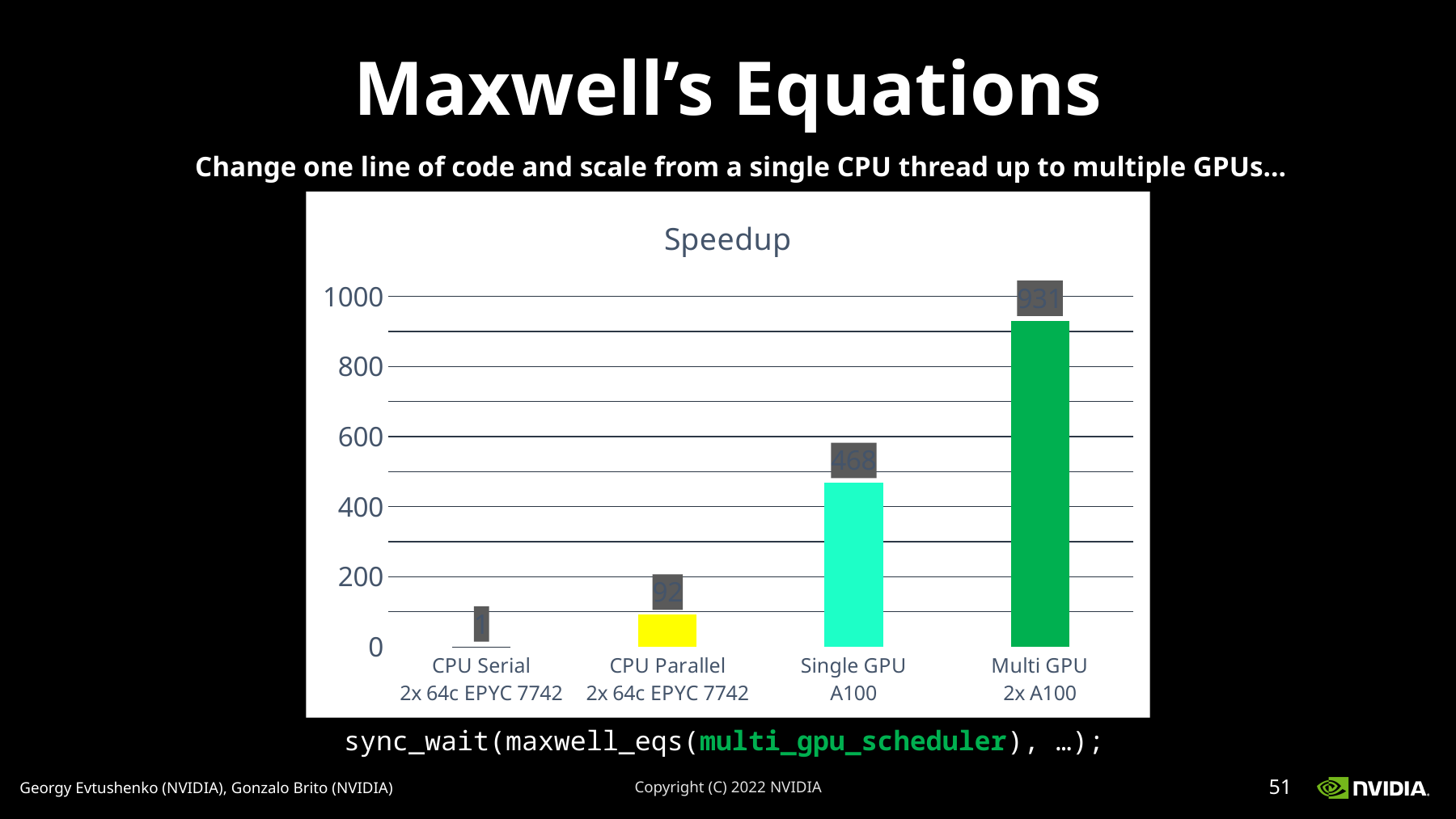
How many categories are shown in the chart? 4 Which category has the highest speedup? Multi GPU 2x A100 What kind of chart is shown on the slide? Bar chart What is the speedup value for CPU Parallel 2x 64c EPYC 7742? 92 Which category has the lowest speedup? CPU Serial 2x 64c EPYC 7742 Is the speedup for Single GPU A100 greater or less than 400? greater What is the difference in speedup between Multi GPU 2x A100 and Single GPU A100? 463 What is the speedup value for Single GPU A100? 468 What is the speedup value for CPU Serial 2x 64c EPYC 7742? 1 What is the speedup value for Multi GPU 2x A100? 931 What is the title of the chart? Speedup Which has a larger speedup, CPU Parallel or Single GPU A100? Single GPU A100